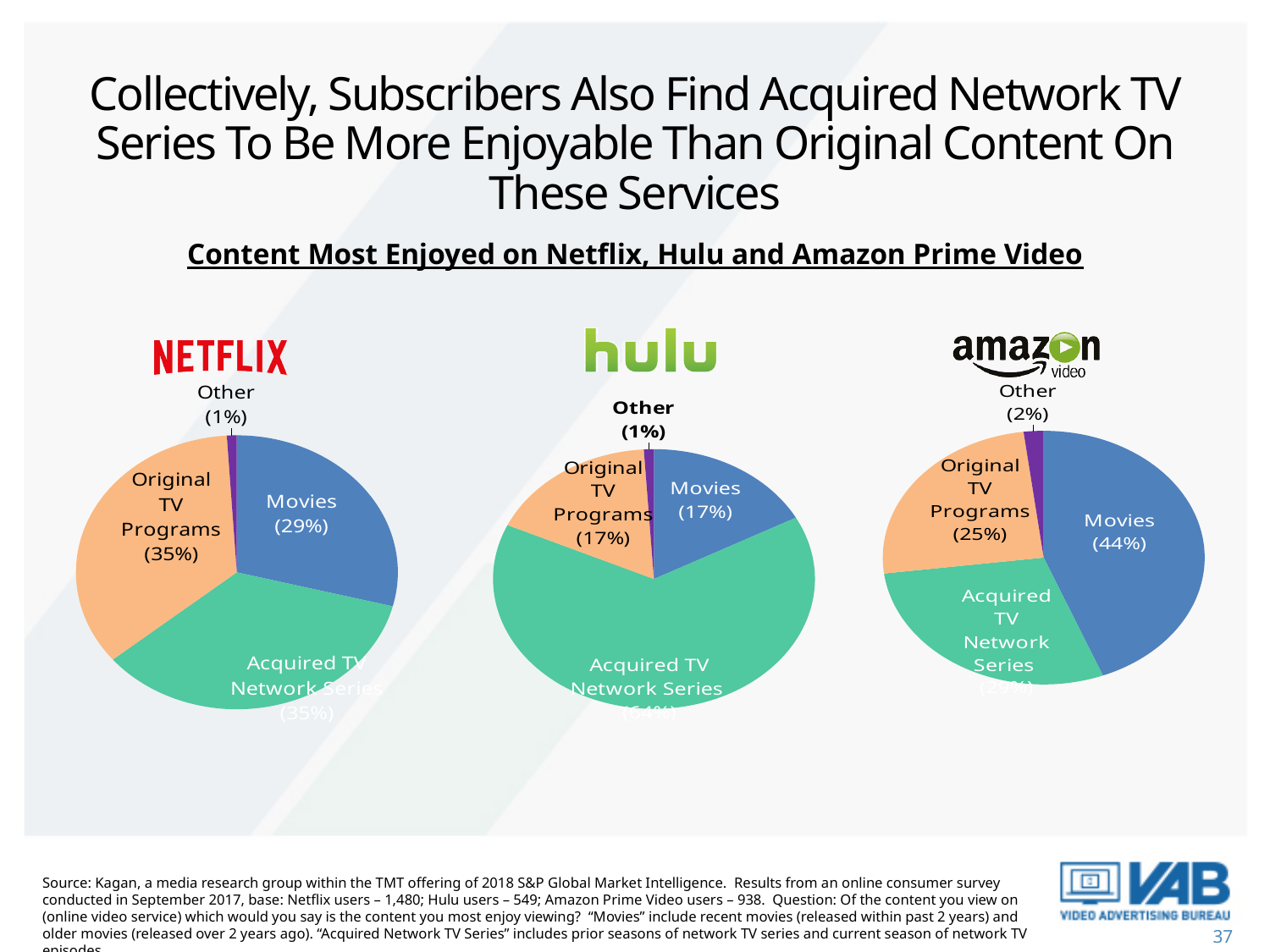
In the Netflix pie chart, what percentage is shown for Original TV Programs? 35% In the Amazon Video pie chart, what percentage is shown for Movies? 44% In the Amazon Video pie chart, what percentage is shown for Other? 2% What type of chart is used for each service on this slide? Pie chart In the Hulu pie chart, what percentage is shown for Original TV Programs? 17% In the Hulu pie chart, which content type has the largest share? Acquired TV Network Series In the Amazon Video pie chart, which content type has the smallest share? Other In the Netflix pie chart, what share of subscribers most enjoy Movies? 29% Which service shows a larger share for Movies, Netflix or Amazon Video? Amazon Video How many slices does the Netflix pie chart have? 4 In the Amazon Video pie chart, how many percentage points larger is Movies than Original TV Programs? 19 percentage points In the Hulu pie chart, what percentage is shown for Acquired TV Network Series? 64%